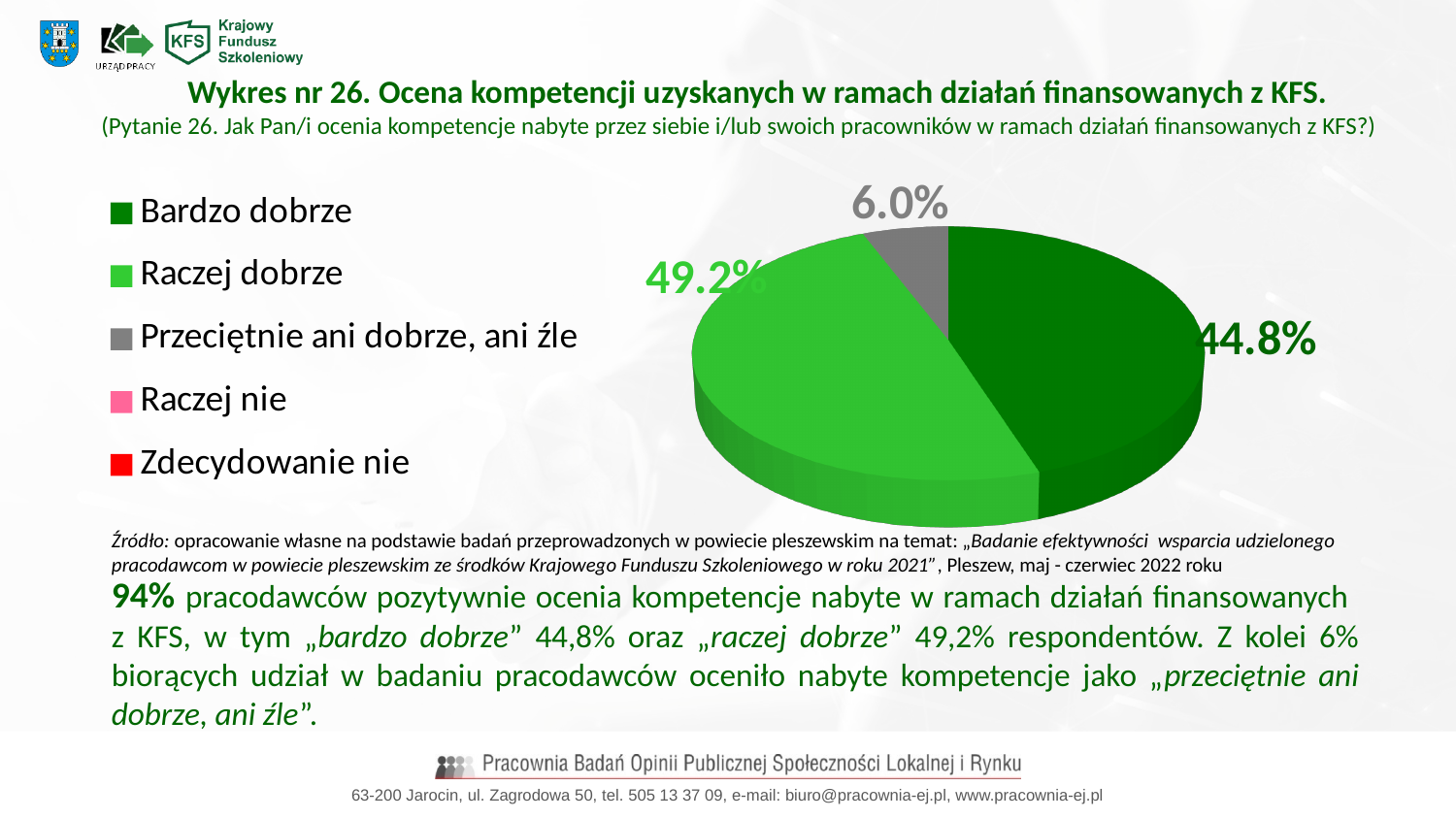
What percentage of the pie chart is labelled for "Raczej dobrze"? 49.2% What colour is the "Przeciętnie ani dobrze, ani źle" slice in the pie chart? Gray What percentage of the pie chart is labelled for "Bardzo dobrze"? 44.8% What is the difference in percentage points between the "Bardzo dobrze" and "Przeciętnie ani dobrze, ani źle" slices? 38.8 Which slice is larger: "Bardzo dobrze" or "Przeciętnie ani dobrze, ani źle"? Bardzo dobrze Which category has the largest slice in the pie chart? Raczej dobrze Which slice is larger: "Bardzo dobrze" or "Raczej dobrze"? Raczej dobrze What type of chart is shown on the slide? Pie chart What is the difference in percentage points between the "Raczej dobrze" and "Bardzo dobrze" slices? 4.4 Which category has the smallest visible slice in the pie chart? Przeciętnie ani dobrze, ani źle How many categories does the legend of the chart list? 5 What percentage of the pie chart is labelled for "Przeciętnie ani dobrze, ani źle"? 6.0%